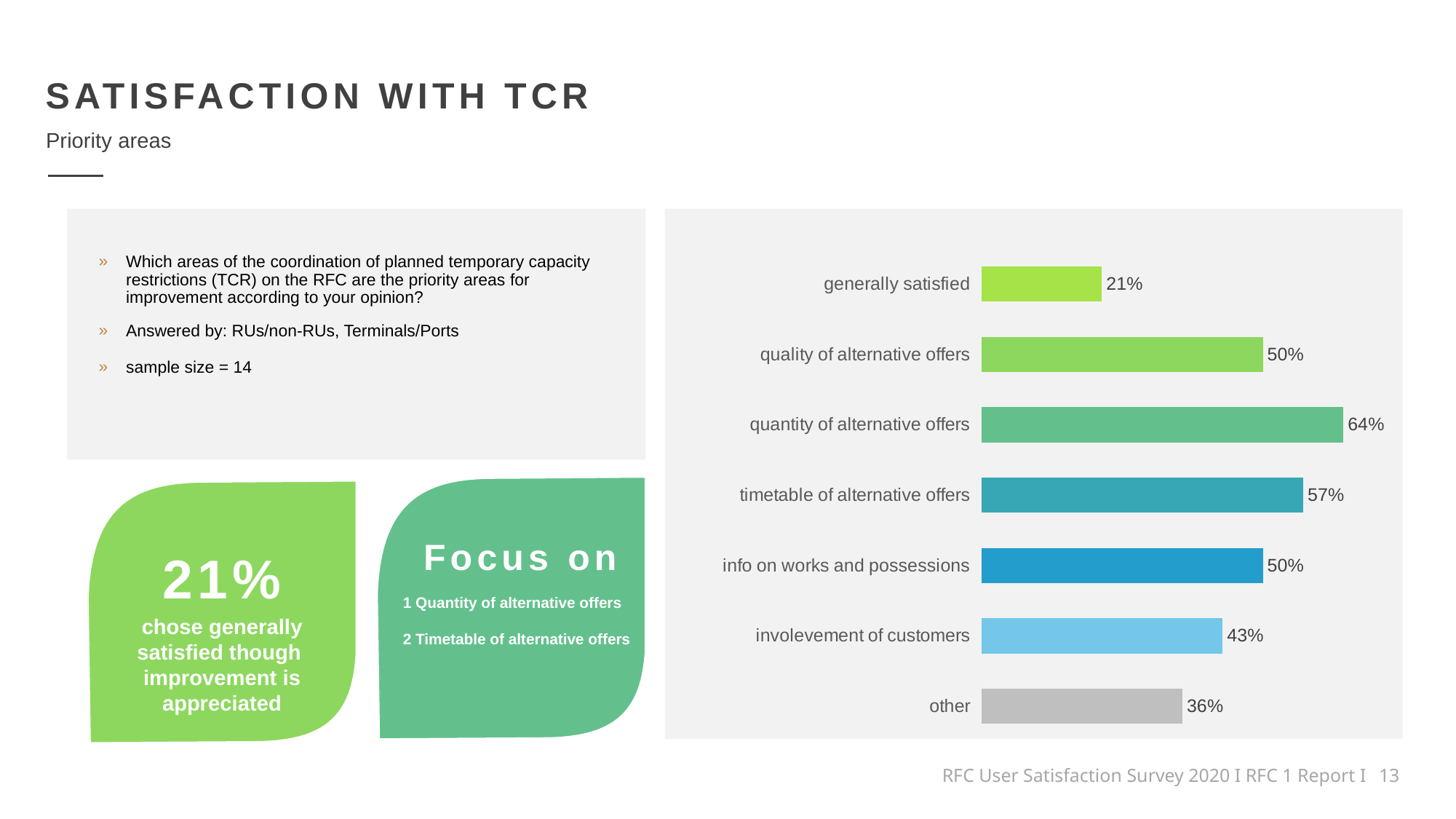
What percentage is shown for 'involevement of customers'? 43% Which category has the highest percentage? quantity of alternative offers What percentage is shown for 'quantity of alternative offers'? 64% What type of chart is shown on the slide? bar chart Which two categories share the same value of 50%? quality of alternative offers and info on works and possessions How many categories are shown in the bar chart? 7 What percentage is shown for 'other'? 36% Which category has the lowest percentage? generally satisfied What is the difference in percentage points between 'quantity of alternative offers' and 'timetable of alternative offers'? 7 What is the difference in percentage points between 'info on works and possessions' and 'other'? 14 What percentage is shown for 'generally satisfied'? 21% Which is larger: the value for 'timetable of alternative offers' or the value for 'quality of alternative offers'? timetable of alternative offers